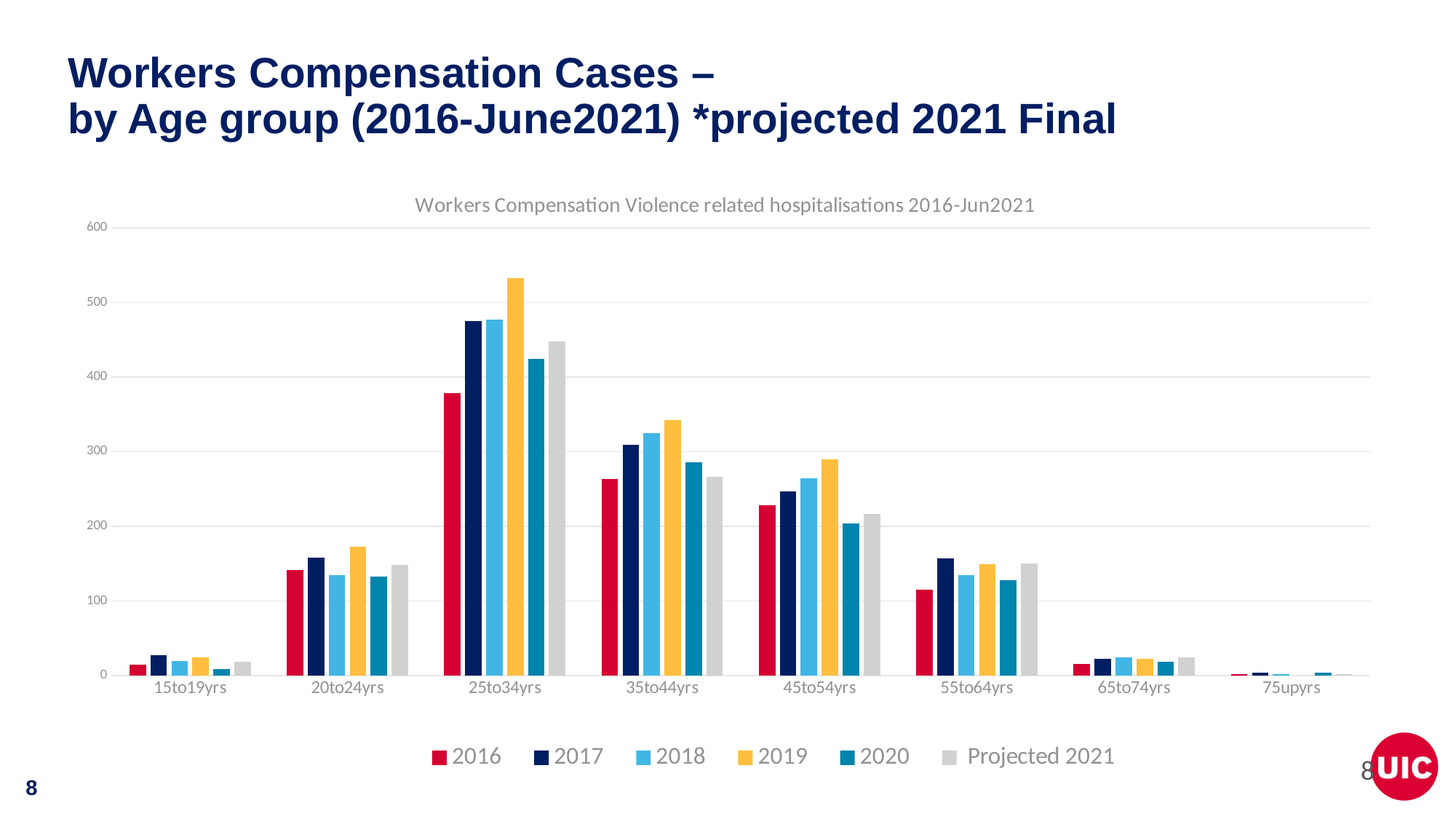
How many age groups are shown on the x axis? 8 In the 35to44yrs group, which is larger: the value for 2016 or the value for 2019? 2019 What kind of chart is shown on the slide? Bar chart Is the value for 2016 in the 45to54yrs group greater or less than 200? greater Which age group has the lowest values across all series? 75upyrs Is the value for 2019 in the 25to34yrs group greater or less than 500? greater How many series does the legend list? 6 In the 20to24yrs group, which is larger: the value for 2017 or the value for 2018? 2017 Which age group has the highest value for 2019? 25to34yrs What is the title printed above the chart's plot area? Workers Compensation Violence related hospitalisations 2016-Jun2021 Is the value for 2016 in the 25to34yrs group greater or less than 400? less